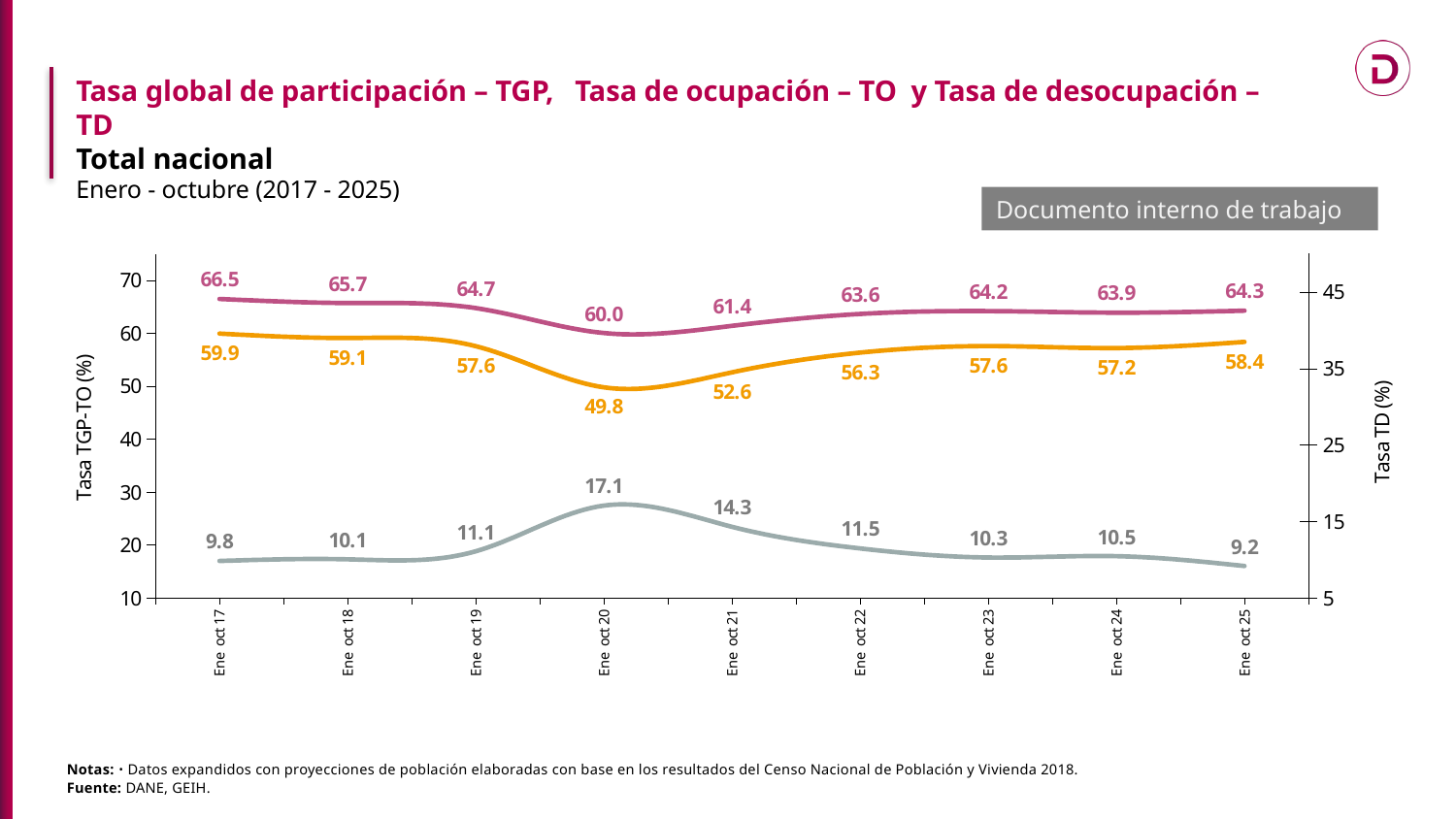
What is the difference between the TGP value for Ene oct 17 and the TGP value for Ene oct 20? 6.5 In which period does the TO (orange line) reach its lowest value? Ene oct 20 What is the label of the right-hand vertical axis? Tasa TD (%) What is the difference between the TD value for Ene oct 20 and the TD value for Ene oct 17? 7.3 In which period does the TD (gray line) reach its highest value? Ene oct 20 What kind of chart is shown on the slide? Line chart Does the TD (gray line) rise or fall from Ene oct 20 to Ene oct 25? Fall How many periods are shown on the x axis? 9 What is the TD (gray line) value for Ene oct 25? 9.2 Which is larger, the TD value for Ene oct 21 or the TD value for Ene oct 22? Ene oct 21 What is the TO (orange line) value for Ene oct 20? 49.8 What is the TGP (pink line) value for Ene oct 17? 66.5